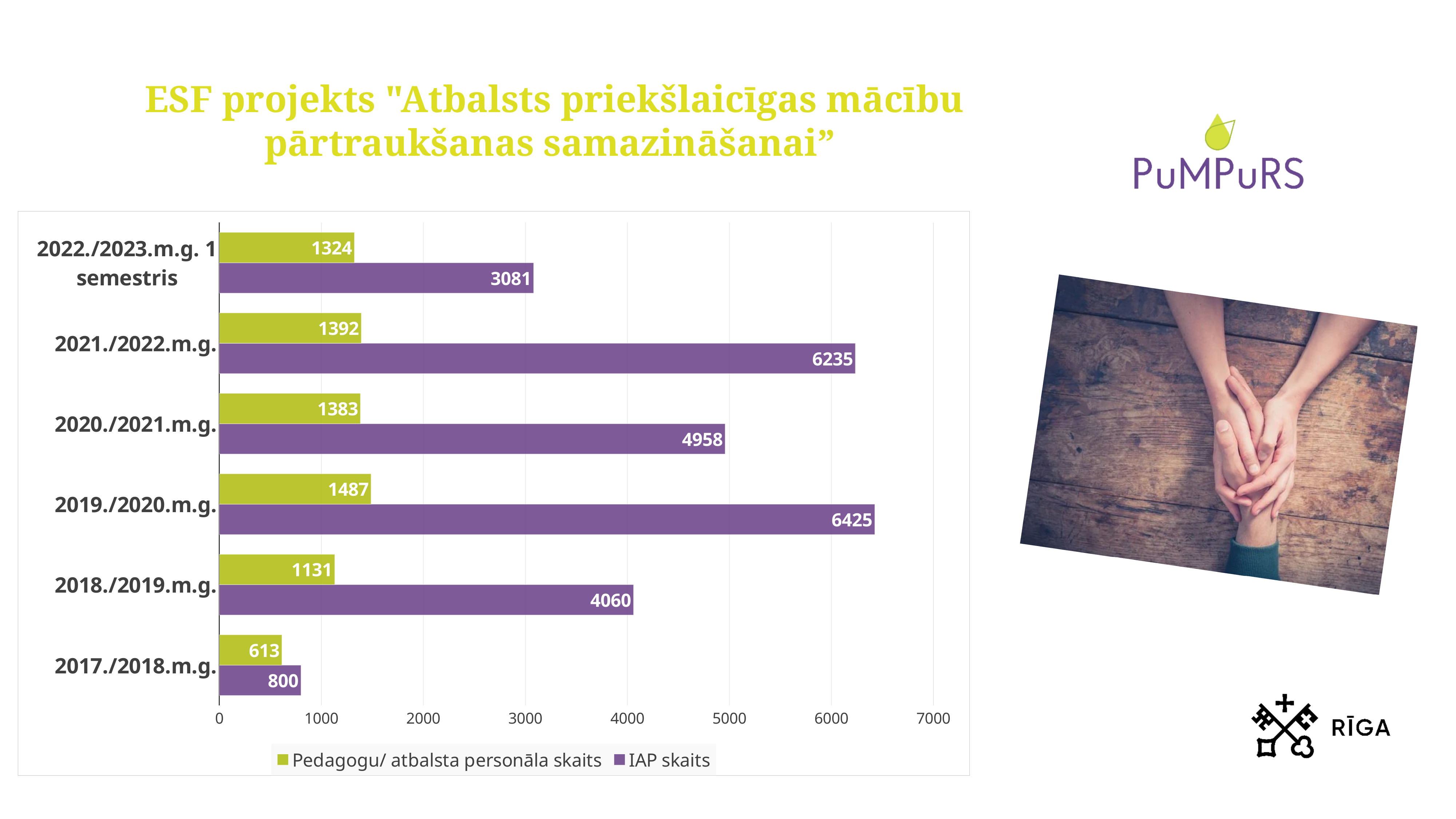
Which school year has the lowest Pedagogu/ atbalsta personāla skaits? 2017./2018.m.g. Is the IAP skaits for 2018./2019.m.g. greater or less than 5000? less How many school-year categories are shown on the chart? 6 What kind of chart is shown on the slide? bar chart What is the difference between the IAP skaits for 2021./2022.m.g. and 2020./2021.m.g.? 1277 What is the IAP skaits value for 2019./2020.m.g.? 6425 How many series does the legend list? 2 Which school year has the highest IAP skaits? 2019./2020.m.g. What is the Pedagogu/ atbalsta personāla skaits value for 2017./2018.m.g.? 613 Which is larger: the Pedagogu/ atbalsta personāla skaits for 2019./2020.m.g. or for 2021./2022.m.g.? 2019./2020.m.g. What is the IAP skaits value for 2022./2023.m.g. 1 semestris? 3081 Which colour represents IAP skaits in the chart? purple